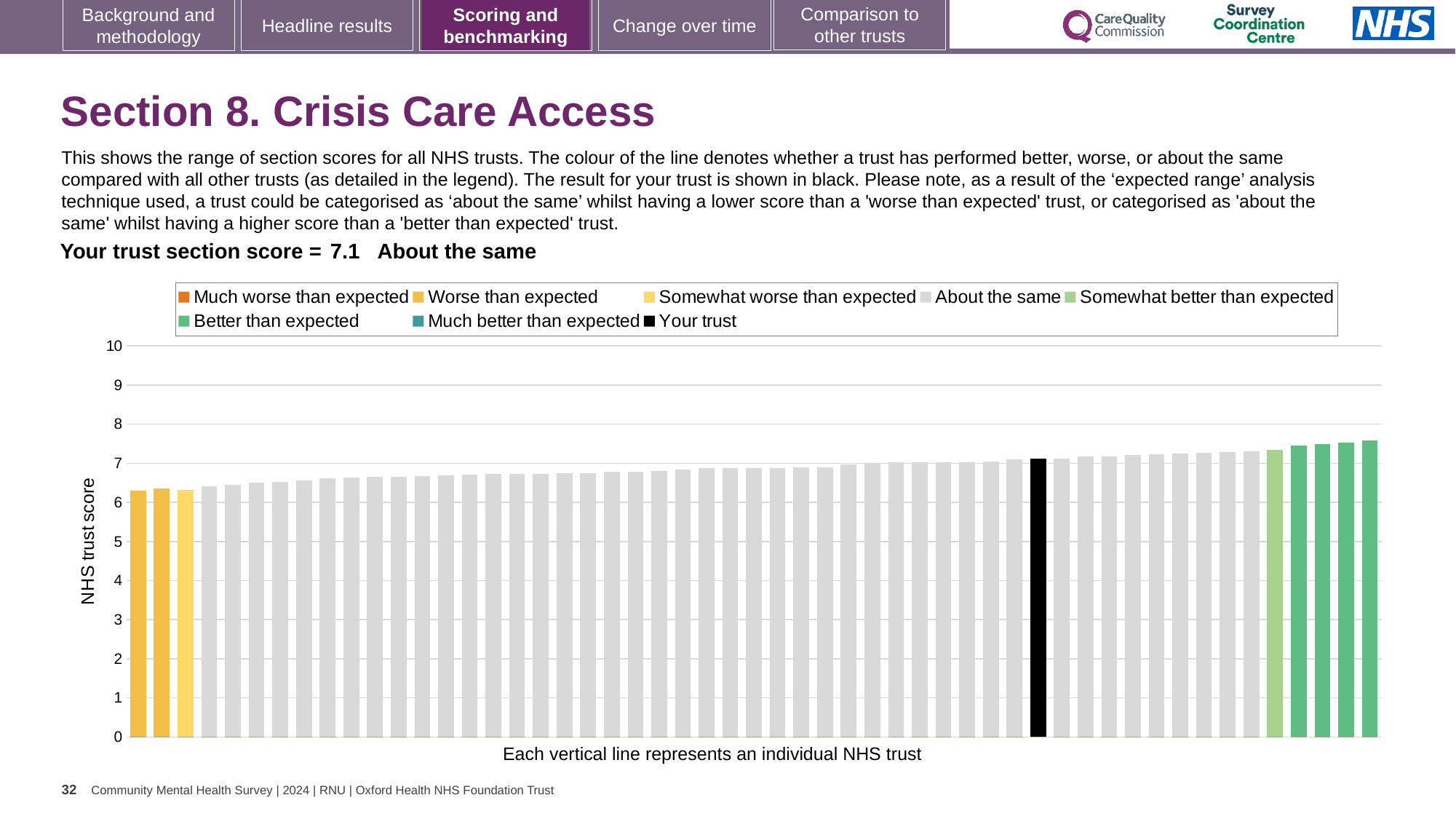
Which performance category is your trust placed in for this section? About the same How many bars are coloured 'Worse than expected' (yellow) in the chart? 2 Which colour represents 'Your trust' in the chart legend? black Is the value for your trust (the black bar) greater or less than 7? greater How many entries does the chart legend list? 8 Is the value of the highest bar in the chart greater or less than 8? less What is the highest value shown on the vertical axis of the chart? 10 Do the bar values rise or fall from left to right along the x axis? rise What kind of chart is shown on the slide? bar chart What is the label on the vertical axis of the chart? NHS trust score What is the section score for your trust shown on the slide? 7.1 Is the value of the lowest bar in the chart greater or less than 7? less